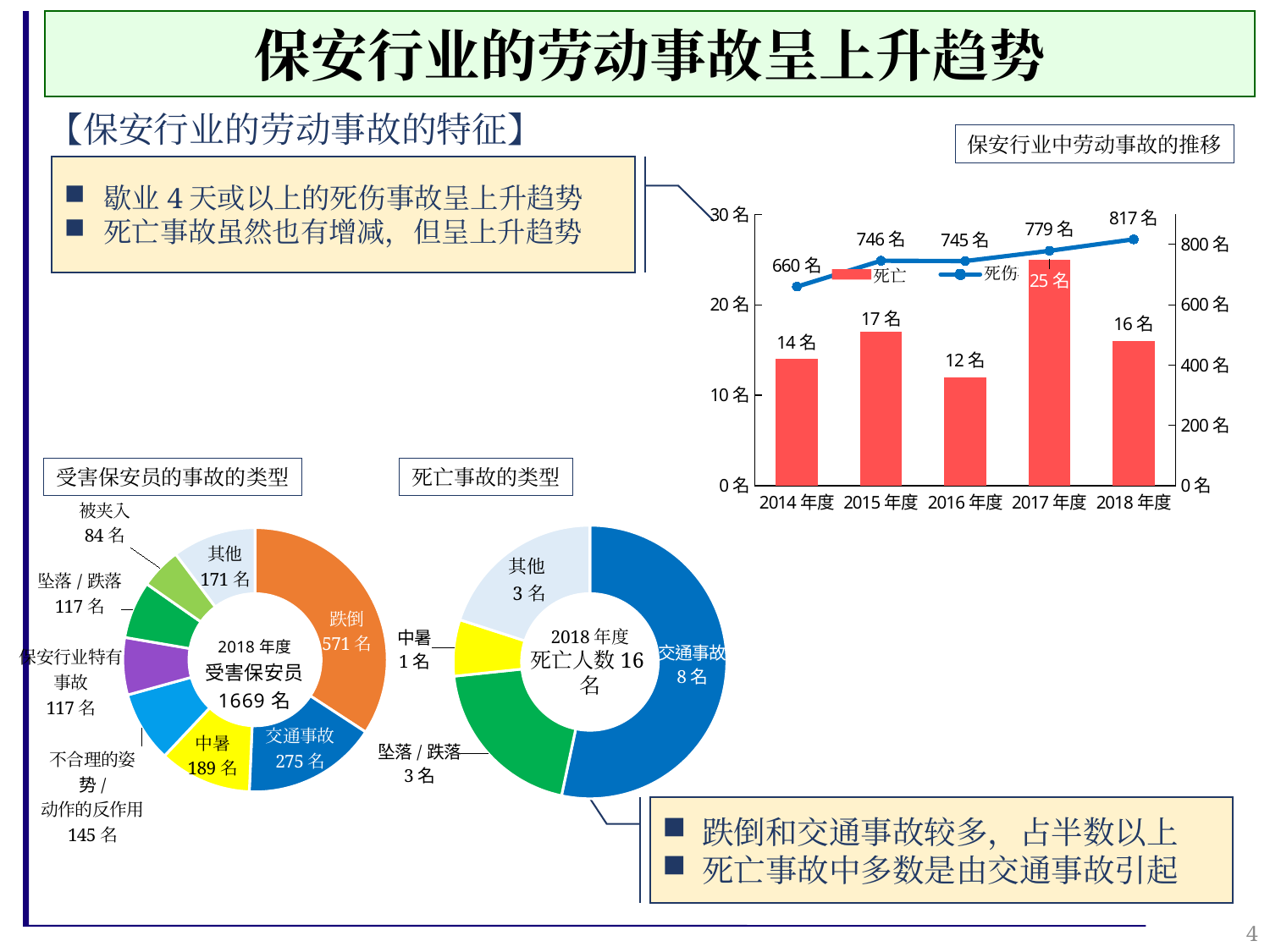
In the chart titled 保安行业中劳动事故的推移, what is the 死伤 value for 2018 年度? 817 名 In the chart titled 保安行业中劳动事故的推移, which year has the lowest 死伤 value? 2014 年度 In the chart titled 保安行业中劳动事故的推移, does the 死伤 line generally rise or fall from 2014 年度 to 2018 年度? rise In the chart titled 受害保安员的事故的类型, which category has the largest value? 跌倒 In the chart titled 死亡事故的类型, what is the value for 交通事故? 8 名 In the chart titled 受害保安员的事故的类型, what is the value for 跌倒? 571 名 In the chart titled 保安行业中劳动事故的推移, what is the difference between the 死伤 values for 2018 年度 and 2014 年度? 157 名 In the chart titled 保安行业中劳动事故的推移, what is the 死亡 value for 2017 年度? 25 名 In the chart titled 保安行业中劳动事故的推移, which year has the highest 死亡 value? 2017 年度 In the chart titled 保安行业中劳动事故的推移, how many series does the legend list? 2 In the chart titled 保安行业中劳动事故的推移, how many years are shown on the x axis? 5 In the chart titled 受害保安员的事故的类型, what is the difference between 跌倒 and 交通事故? 296 名